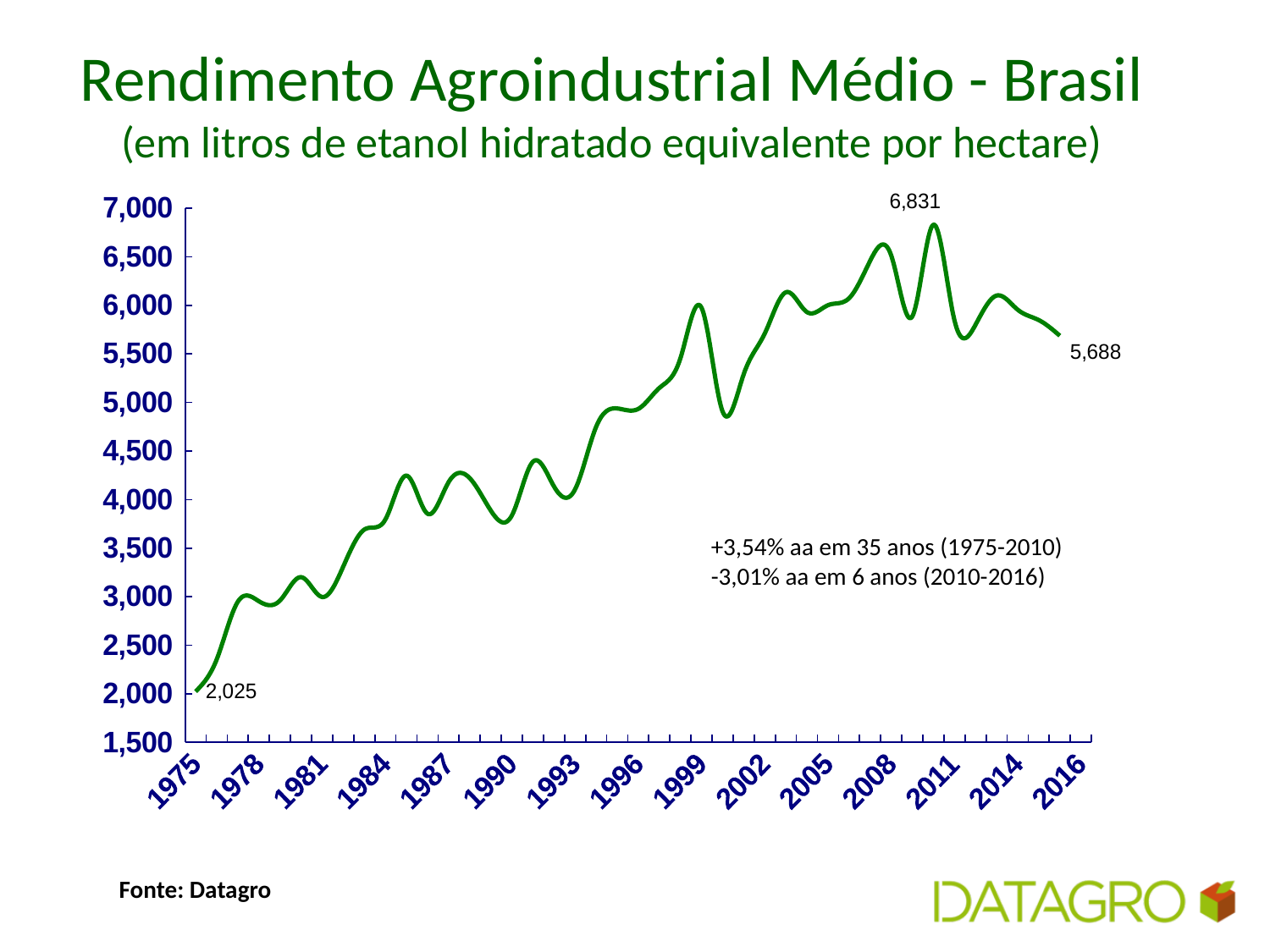
Which is larger, the value for 1975 or the value for 2016? 2016 What annual growth rate does the slide give for the 35 years from 1975 to 2010? +3,54% aa Is the value for 1990 greater or less than 4,000? less What is the value printed for 2016? 5,688 Does the value generally rise or fall from 1975 to 2010? rise What kind of chart is shown on the slide? line chart In which year does the line reach its lowest value? 1975 Is the value for 1999 greater or less than 5,500? greater What is the value printed for 1975? 2,025 What is the highest value labelled on the line? 6,831 By how much did the value increase from 1975 (2,025) to 2016 (5,688)? 3,663 What is the difference between the peak value of 6,831 and the 2016 value of 5,688? 1,143